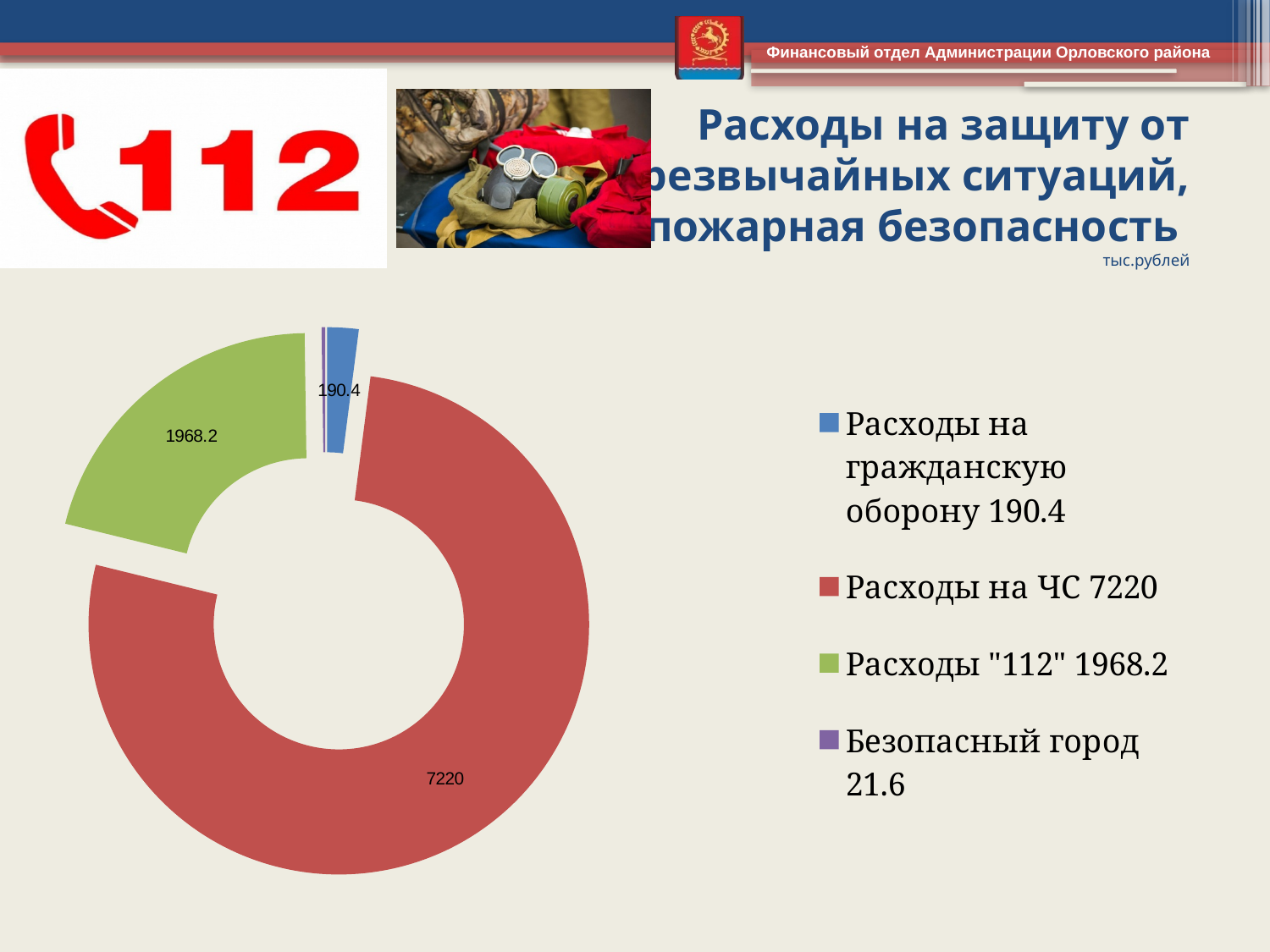
What is the difference between Расходы на ЧС and Расходы "112"? 5251.8 What is the difference between Расходы "112" and Расходы на гражданскую оборону? 1777.8 What is the value for Расходы "112"? 1968.2 Which category has the largest value? Расходы на ЧС Which is larger, Расходы на гражданскую оборону or Безопасный город? Расходы на гражданскую оборону How many categories does the chart show? 4 What unit is stated for the chart values? тыс.рублей What is the value for Расходы на гражданскую оборону? 190.4 What is the value for Расходы на ЧС? 7220 What is the value for Безопасный город? 21.6 Which category has the smallest value? Безопасный город What kind of chart is shown on the slide? doughnut chart